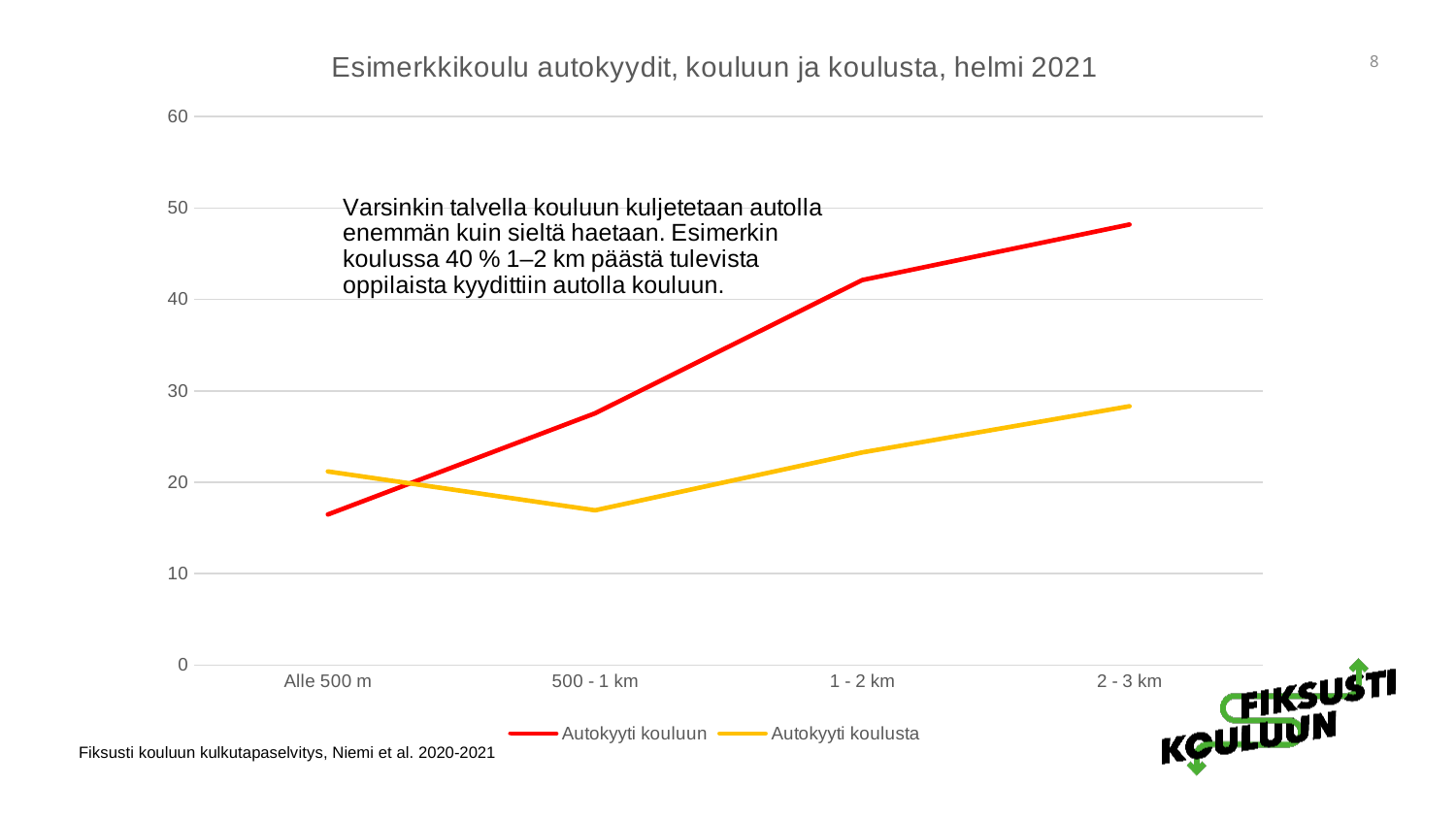
What is the title of the chart? Esimerkkikoulu autokyydit, kouluun ja koulusta, helmi 2021 Is the value for Autokyyti kouluun at 1 - 2 km greater or less than 40? greater Which series is drawn in red? Autokyyti kouluun What kind of chart is shown on the slide? line chart For which distance category is Autokyyti koulusta lowest? 500 - 1 km How many distance categories are shown on the x axis? 4 Is the value for Autokyyti kouluun at Alle 500 m greater or less than 20? less Is the value for Autokyyti kouluun at 2 - 3 km greater or less than 50? less How many series does the legend list? 2 For which distance category is Autokyyti kouluun highest? 2 - 3 km At 1 - 2 km, which series has the larger value, Autokyyti kouluun or Autokyyti koulusta? Autokyyti kouluun